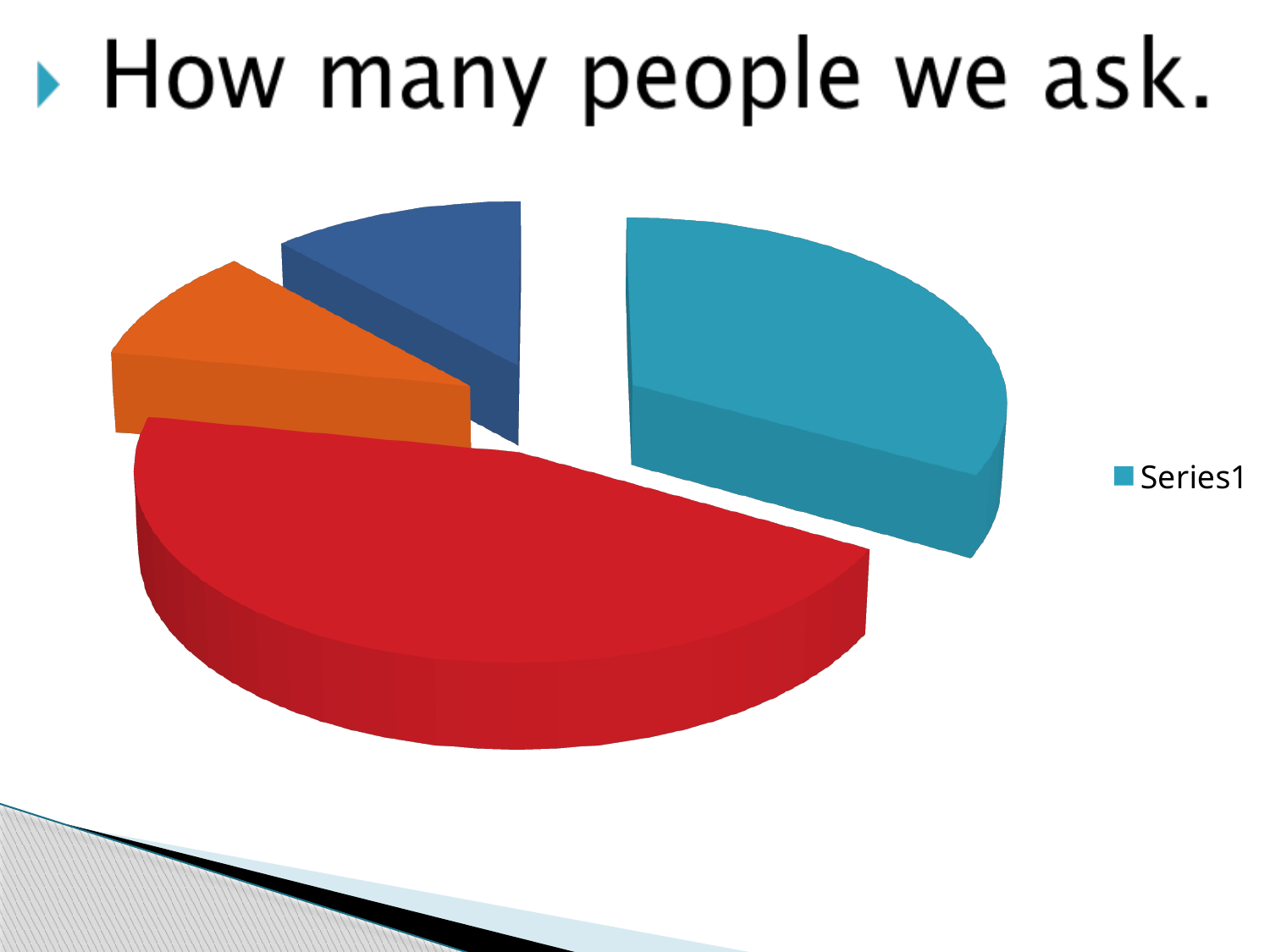
Which is larger in the pie chart, the red slice or the dark blue slice? the red slice What is the only entry shown in the pie chart's legend? Series1 What colour is the largest slice of the pie chart? red Which is larger in the pie chart, the red slice or the teal slice? the red slice What kind of chart is shown on the slide? pie chart Which is larger in the pie chart, the teal slice or the orange slice? the teal slice Which slice of the pie chart is the largest? the red slice How many series does the legend of the pie chart list? 1 How many slices does the pie chart have? 4